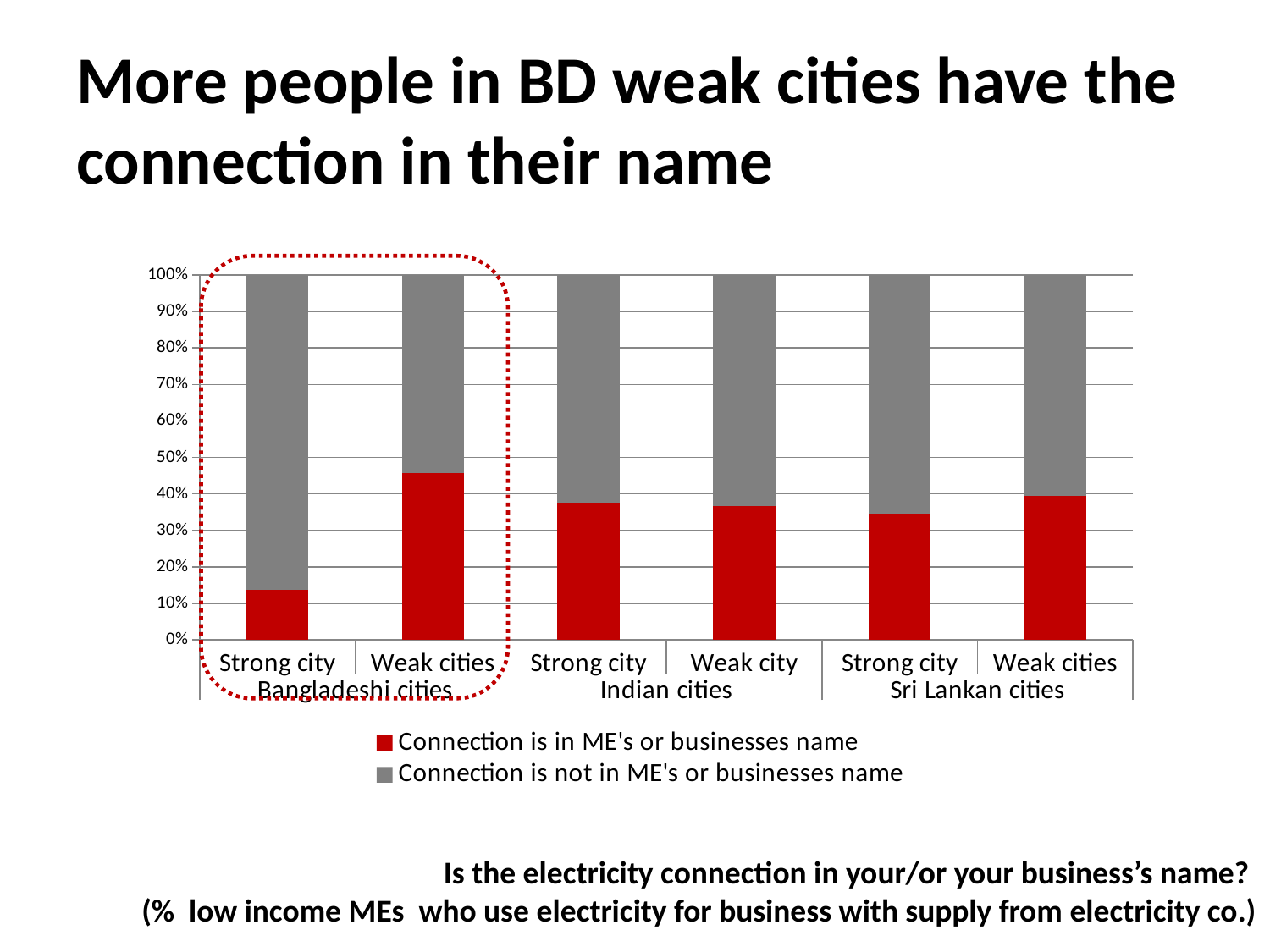
What kind of chart is shown on the slide? Stacked bar chart How many country groups are shown on the x axis? 3 Among the Bangladeshi cities, which has the larger share for 'Connection is in ME's or businesses name': Strong city or Weak cities? Weak cities How many bars are plotted in the chart? 6 Which bar has the largest share for 'Connection is in ME's or businesses name'? Weak cities (Bangladeshi cities) What is the total height of each stacked bar on the y axis? 100% Is the share for 'Connection is in ME's or businesses name' in the Bangladeshi Weak cities greater or less than 40%? greater Which bar has the smallest share for 'Connection is in ME's or businesses name'? Strong city (Bangladeshi cities) How many series does the legend list? 2 Is the share for 'Connection is in ME's or businesses name' in the Indian Strong city greater or less than 50%? less Is the share for 'Connection is in ME's or businesses name' in the Bangladeshi Strong city greater or less than 20%? less Which colour represents 'Connection is not in ME's or businesses name' in the legend? Grey